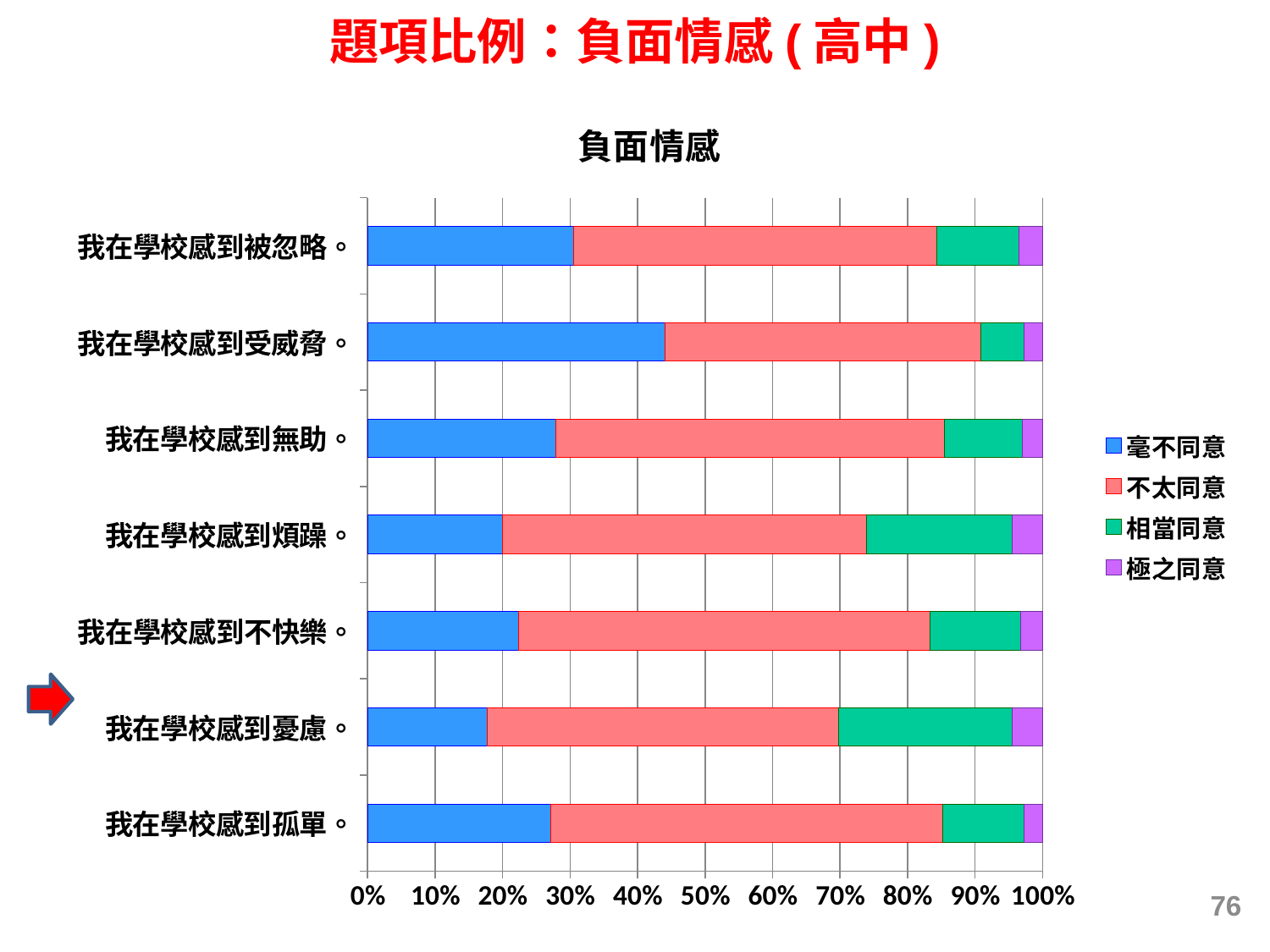
What is the title of the chart? 負面情感 How many statements (categories) are plotted on the chart? 7 How many series does the legend list? 4 Which statement has the largest 毫不同意 segment? 我在學校感到受威脅。 What kind of chart is shown on the slide? Stacked bar chart Which has a larger 毫不同意 segment: 我在學校感到受威脅。 or 我在學校感到無助。? 我在學校感到受威脅。 Is the 毫不同意 share for 我在學校感到受威脅。 greater or less than 40%? greater Which colour represents 極之同意 in the chart? Purple Which statement has the largest 相當同意 segment? 我在學校感到憂慮。 What does each stacked bar total on the x axis? 100% Is the 毫不同意 share for 我在學校感到無助。 greater or less than 30%? less Is the 毫不同意 share for 我在學校感到憂慮。 greater or less than 20%? less